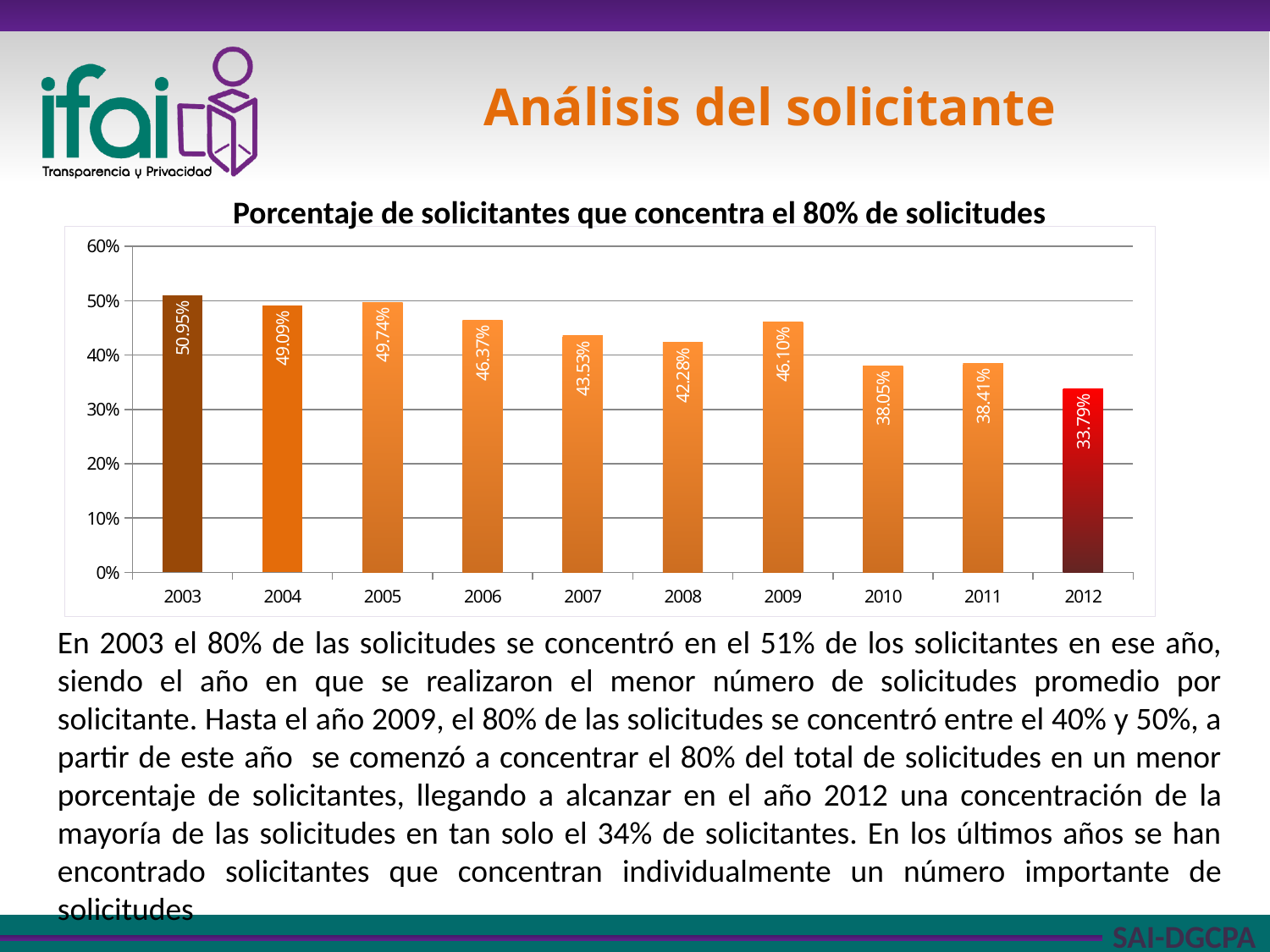
What kind of chart is this? bar chart Which year has the highest value? 2003 Do the values generally rise or fall from 2003 to 2012? fall What is the value for 2009? 46.10% What is the value for 2003? 50.95% How many years are shown on the x axis? 10 What is the value for 2012? 33.79% What is the difference between the values for 2003 and 2012? 17.16% What is the title of the chart? Porcentaje de solicitantes que concentra el 80% de solicitudes Which year has the lowest value? 2012 Which is larger, the value for 2006 or the value for 2009? 2006 Is the value for 2010 greater or less than 40%? less